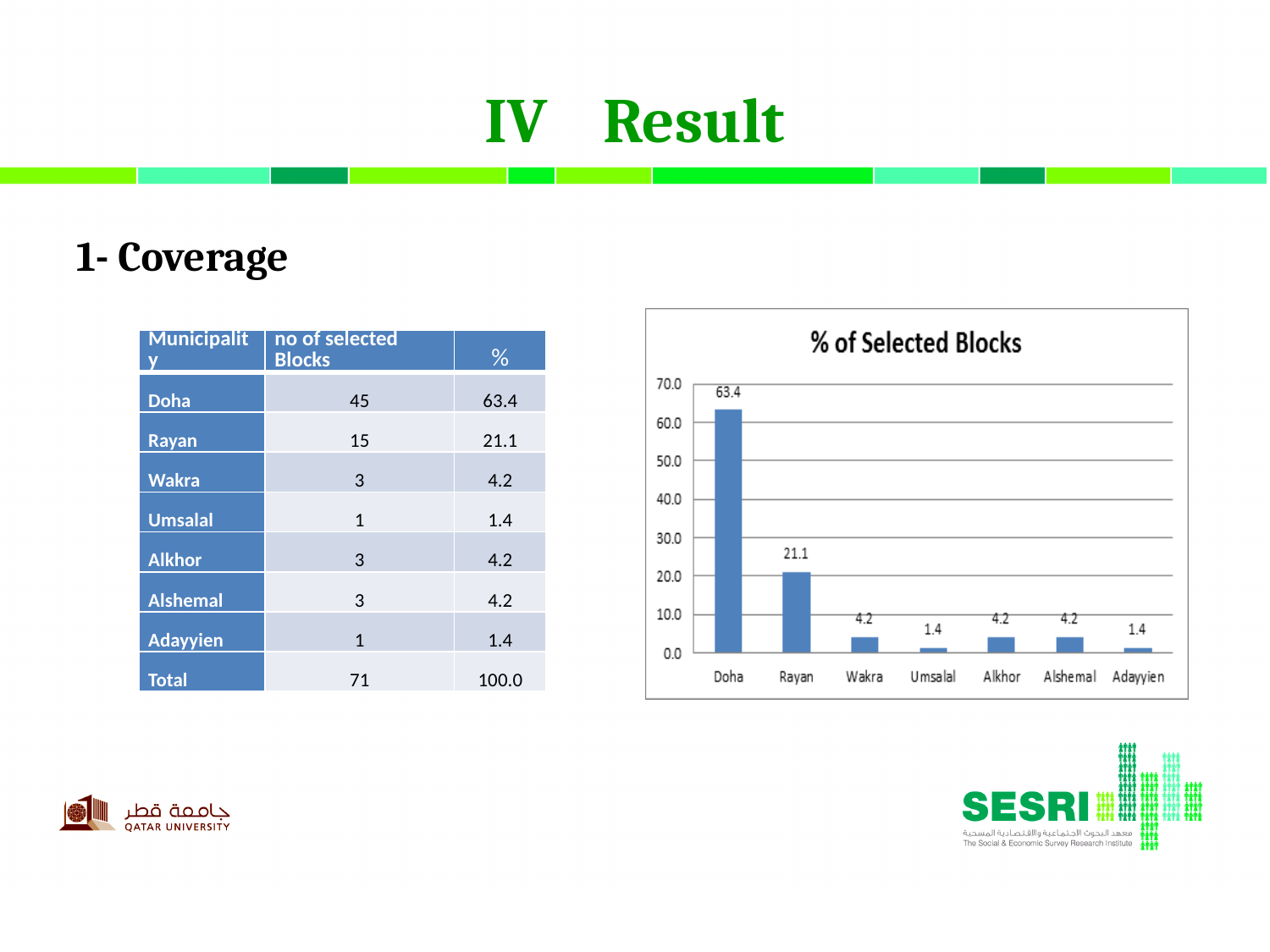
How many municipalities are shown on the x axis of the '% of Selected Blocks' chart? 7 What is the highest tick value shown on the y axis of the '% of Selected Blocks' chart? 70.0 Which is larger in the '% of Selected Blocks' chart, the value for Wakra or the value for Umsalal? Wakra What is the difference between the values for Alkhor and Adayyien in the '% of Selected Blocks' chart? 2.8 Is the value for Rayan in the '% of Selected Blocks' chart greater or less than 30.0? less What is the difference between the values for Doha and Rayan in the '% of Selected Blocks' chart? 42.3 What is the value for Doha in the '% of Selected Blocks' chart? 63.4 What is the value for Umsalal in the '% of Selected Blocks' chart? 1.4 What kind of chart is the '% of Selected Blocks' chart? bar chart Which municipality has the highest value in the '% of Selected Blocks' chart? Doha What is the value for Rayan in the '% of Selected Blocks' chart? 21.1 What is the title of the chart on the slide? % of Selected Blocks